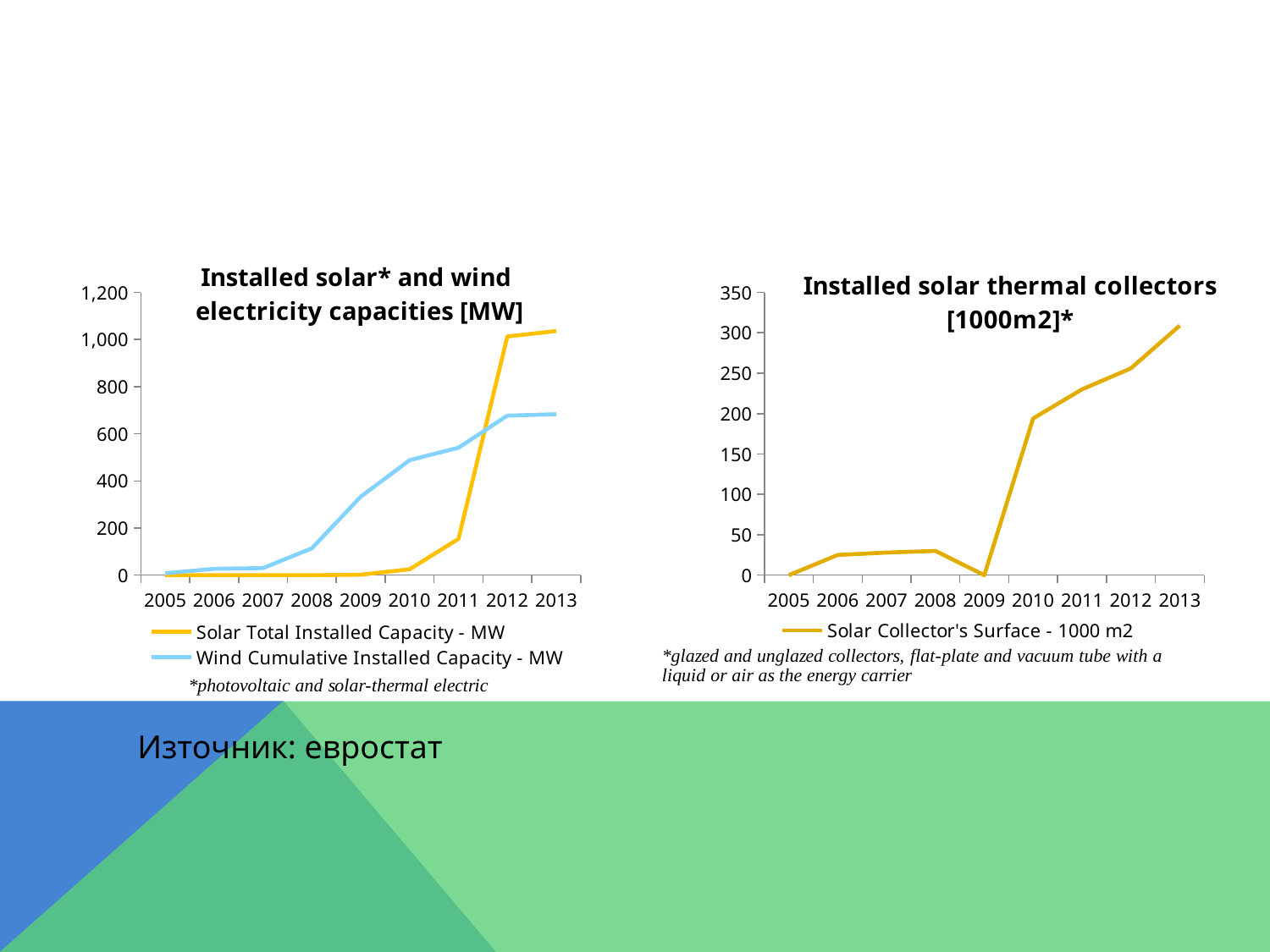
In the 'Installed solar* and wind electricity capacities [MW]' chart, which series has the larger value in 2010, Solar Total Installed Capacity or Wind Cumulative Installed Capacity? Wind Cumulative Installed Capacity How many years are shown on the x axis of the 'Installed solar thermal collectors [1000m2]*' chart? 9 In the 'Installed solar* and wind electricity capacities [MW]' chart, is the Solar Total Installed Capacity value for 2013 greater or less than 1,000? greater In the 'Installed solar thermal collectors [1000m2]*' chart, which year has the highest Solar Collector's Surface value? 2013 In the 'Installed solar* and wind electricity capacities [MW]' chart, is the Wind Cumulative Installed Capacity value for 2013 greater or less than 800? less In the 'Installed solar* and wind electricity capacities [MW]' chart, which series has the larger value in 2013, Solar Total Installed Capacity or Wind Cumulative Installed Capacity? Solar Total Installed Capacity In the 'Installed solar thermal collectors [1000m2]*' chart, is the value for 2009 greater or less than 50? less In the 'Installed solar thermal collectors [1000m2]*' chart, does the Solar Collector's Surface value rise or fall from 2009 to 2013? rise What kind of chart is the 'Installed solar* and wind electricity capacities [MW]' chart? line chart How many series does the legend of the 'Installed solar* and wind electricity capacities [MW]' chart list? 2